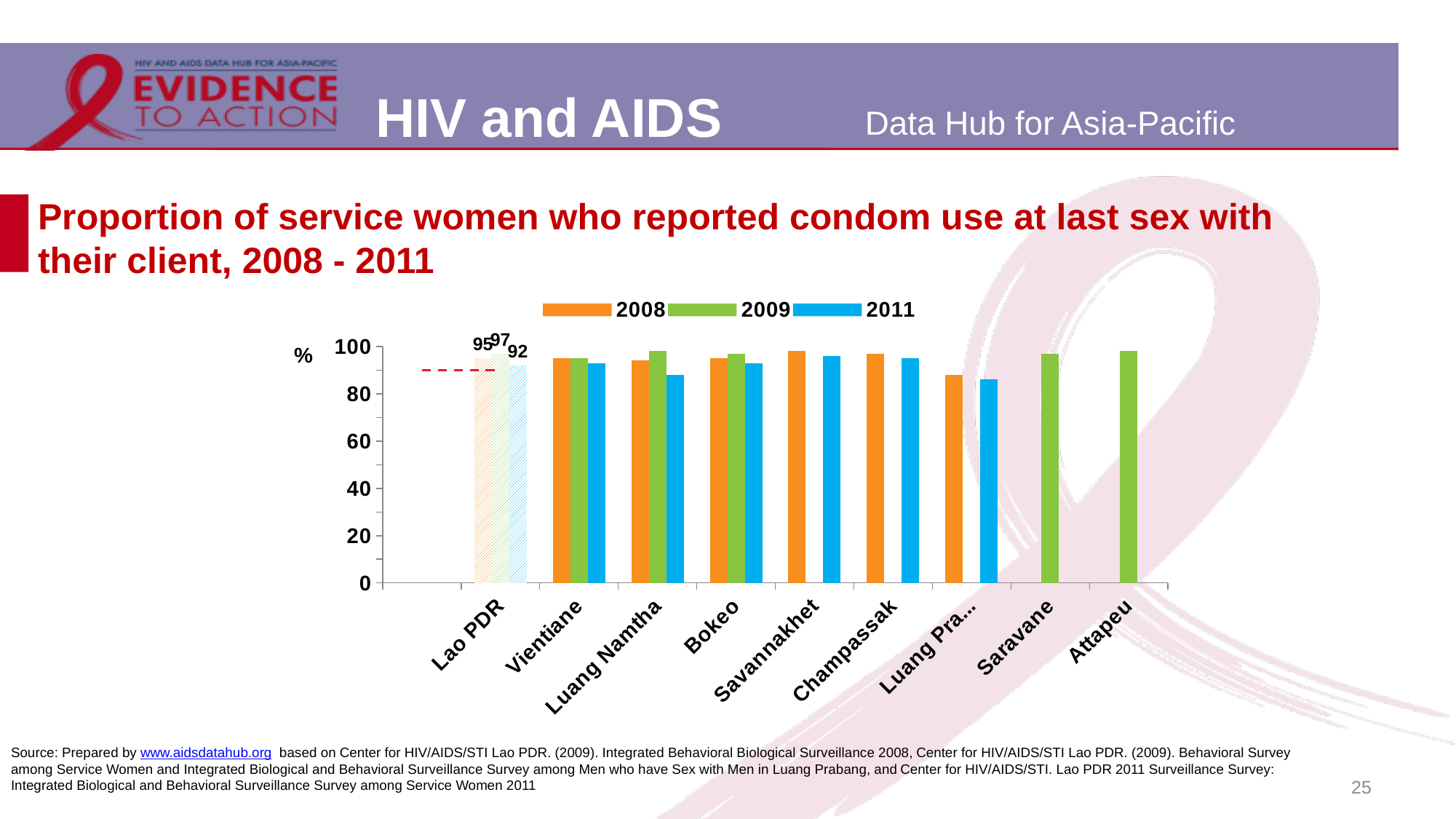
What is the value for Lao PDR in 2008? 95 For Lao PDR, is the 2008 value or the 2011 value larger? 2008 For Lao PDR, which year has the lowest value? 2011 Is the value for Luang Namtha in 2011 greater or less than 80? greater What kind of chart is shown on the slide? Bar chart What is the value for Lao PDR in 2011? 92 Which years are listed in the legend? 2008, 2009, 2011 What is the difference between the Lao PDR values for 2009 and 2011? 5 How many series does the legend list? 3 What is the value for Lao PDR in 2009? 97 How many categories are shown on the x axis? 9 For Lao PDR, which year has the highest value? 2009